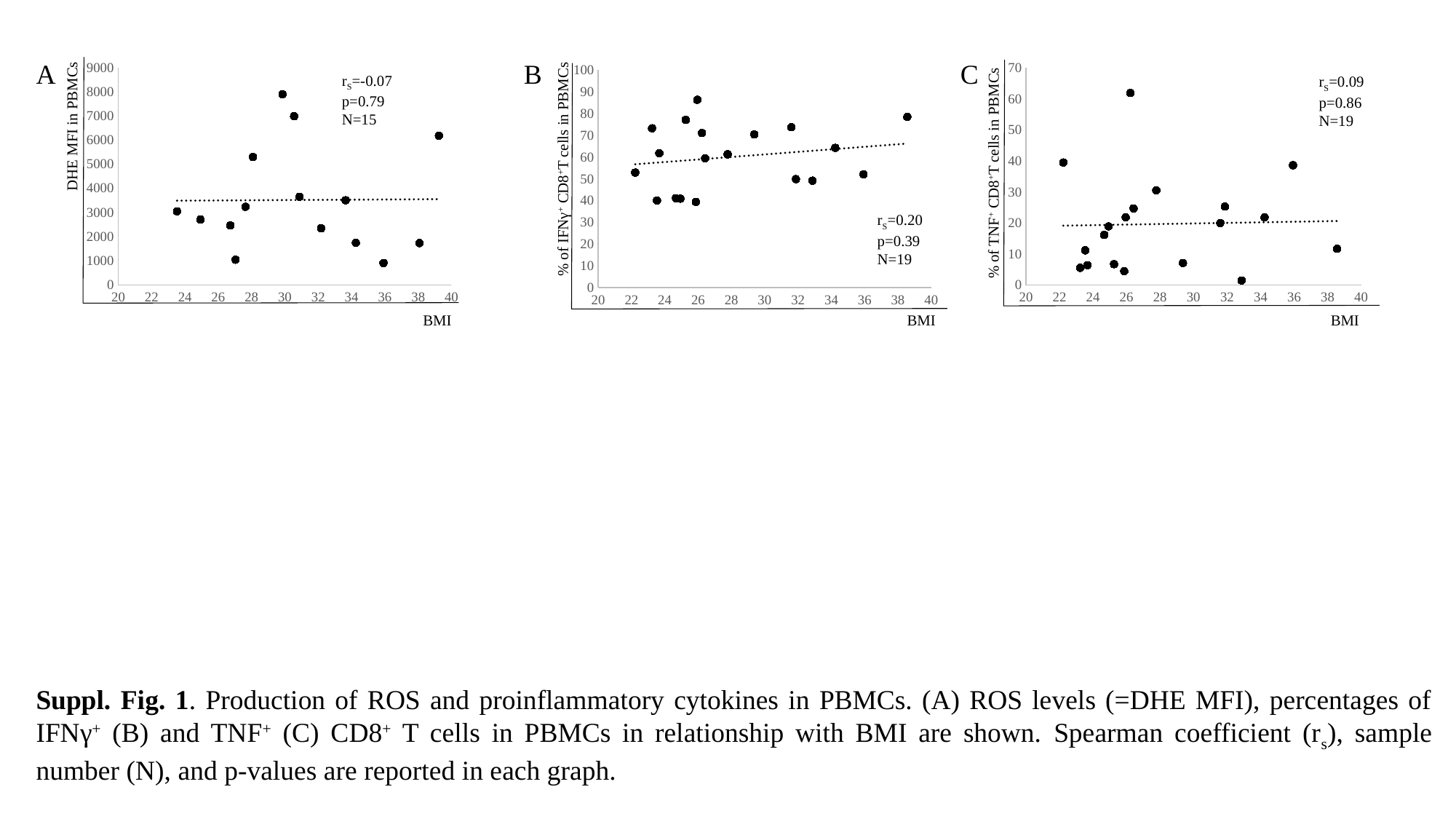
In chart A (DHE MFI in PBMCs), how many samples (N) are reported? 15 What is the y-axis label of chart A? DHE MFI in PBMCs In chart C (% of TNF+ CD8+ T cells in PBMCs), is the highest plotted point greater or less than 60? greater In chart B (% of IFNγ+ CD8+ T cells in PBMCs), what Spearman coefficient (rs) is reported? 0.20 In chart B (% of IFNγ+ CD8+ T cells in PBMCs), is the highest plotted point greater or less than 80? greater In chart B (% of IFNγ+ CD8+ T cells in PBMCs), does the dotted trend line rise or fall as BMI increases? rises What kind of chart is chart A (DHE MFI in PBMCs)? scatter plot In chart A (DHE MFI in PBMCs), is the highest plotted point greater or less than 7000? greater In chart C (% of TNF+ CD8+ T cells in PBMCs), what p-value is reported? 0.86 In chart A (DHE MFI in PBMCs), what p-value is reported? 0.79 In chart B (% of IFNγ+ CD8+ T cells in PBMCs), how many samples (N) are reported? 19